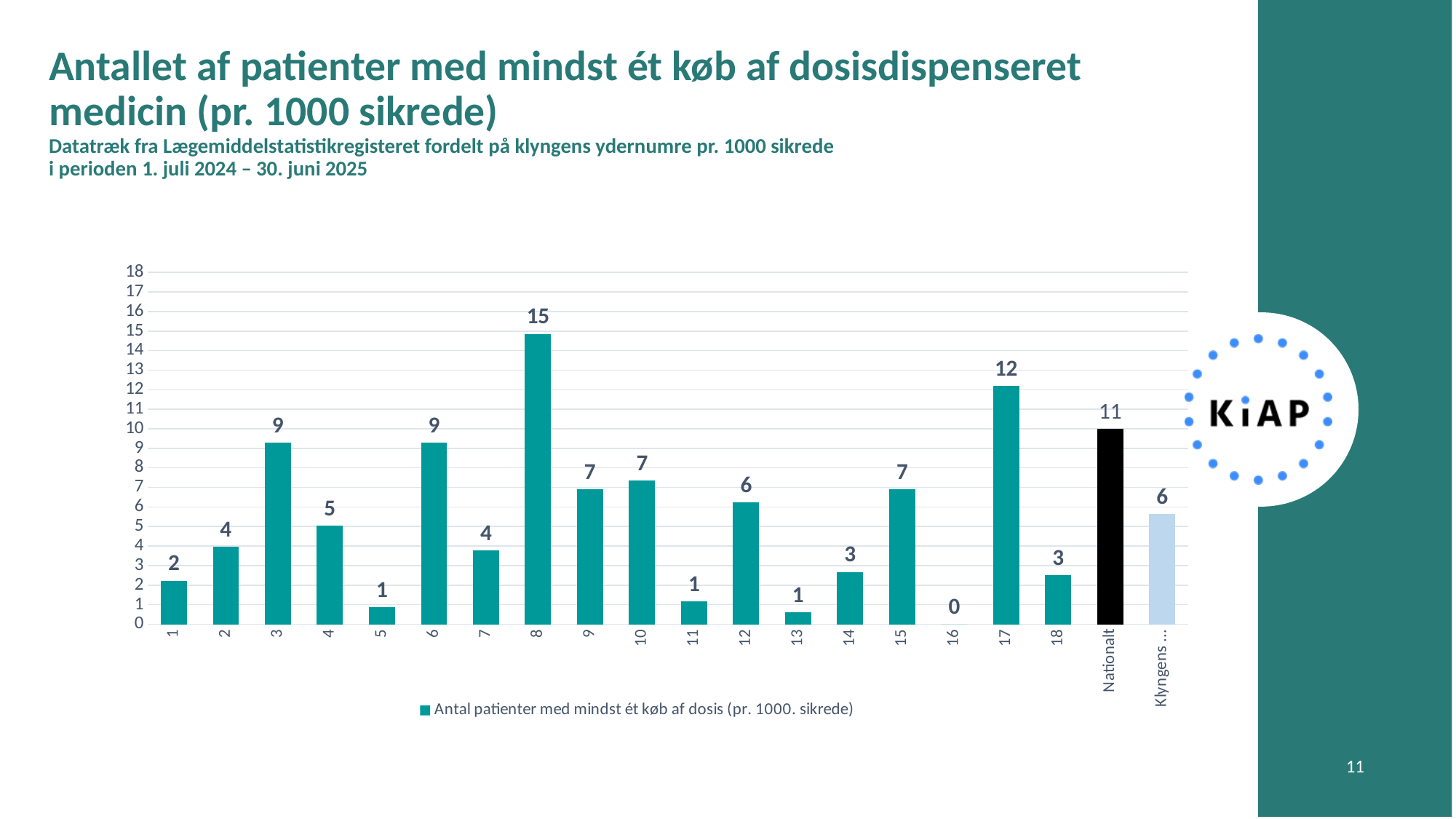
What is the value for category 16? 0 What is the value for category 8? 15 What is the difference between the value for category 8 and the value for Nationalt? 4 What is the legend entry for the series? Antal patienter med mindst ét køb af dosis (pr. 1000. sikrede) How many series does the legend list? 1 Which category has the highest value? 8 What is the value for Nationalt? 11 What type of chart is shown on the slide? bar chart Which category has the lowest value? 16 Is the value for category 17 greater or less than 10? greater Which is larger, the value for category 3 or the value for category 4? category 3 What is the value for category 17? 12